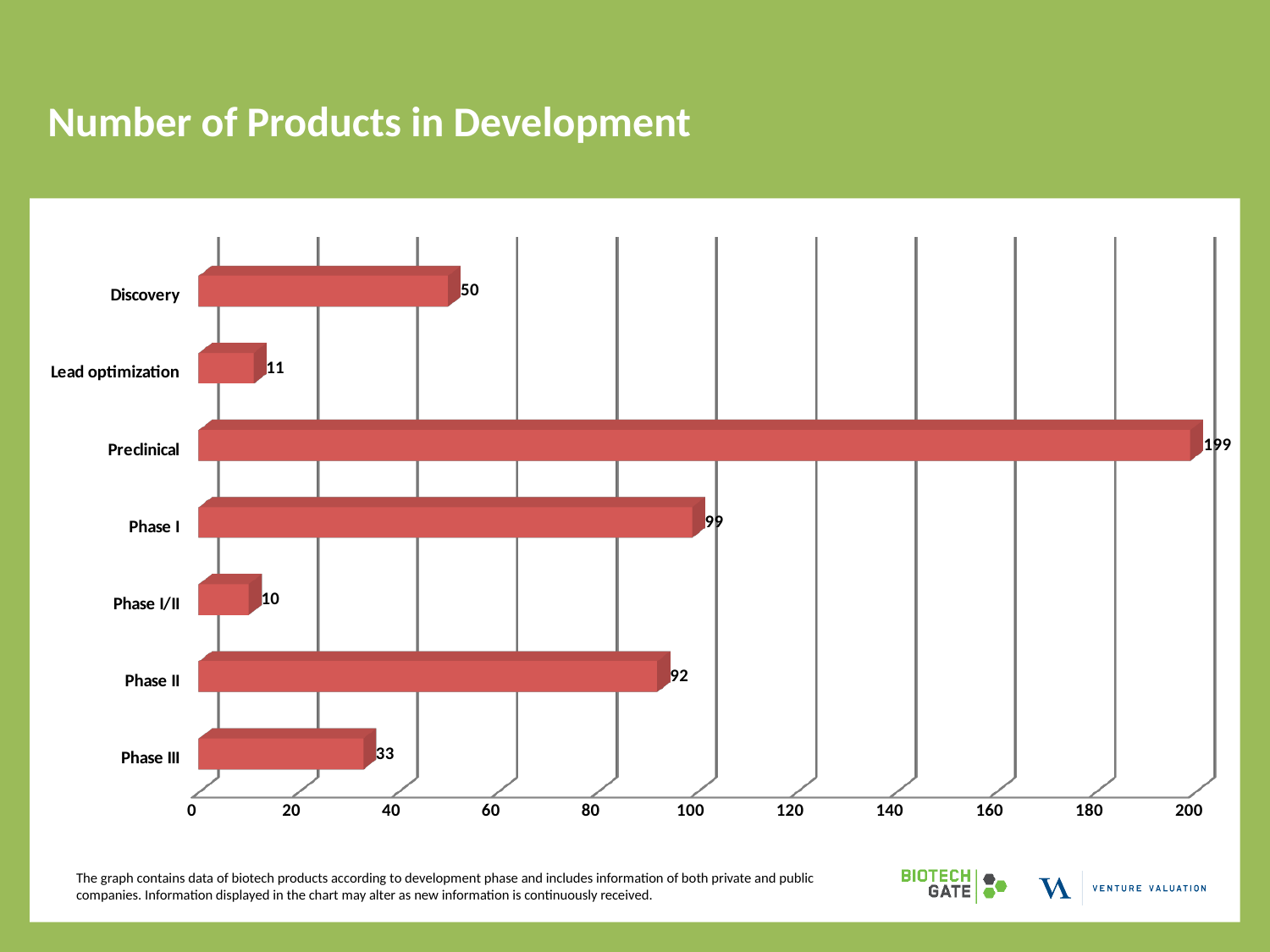
What is the difference between the values for Phase I and Phase II? 7 What is the value shown for Phase II? 92 What is the title of the chart? Number of Products in Development Which development phase has the lowest number of products? Phase I/II What is the number of products in the Preclinical phase? 199 What is the difference between the values for Discovery and Phase III? 17 Which development phase has the highest number of products? Preclinical How many development phases are shown in the chart? 7 What is the value shown for Lead optimization? 11 Which has a larger value, Discovery or Phase III? Discovery Is the value for Phase I greater or less than 80? greater What kind of chart is shown on the slide? Bar chart